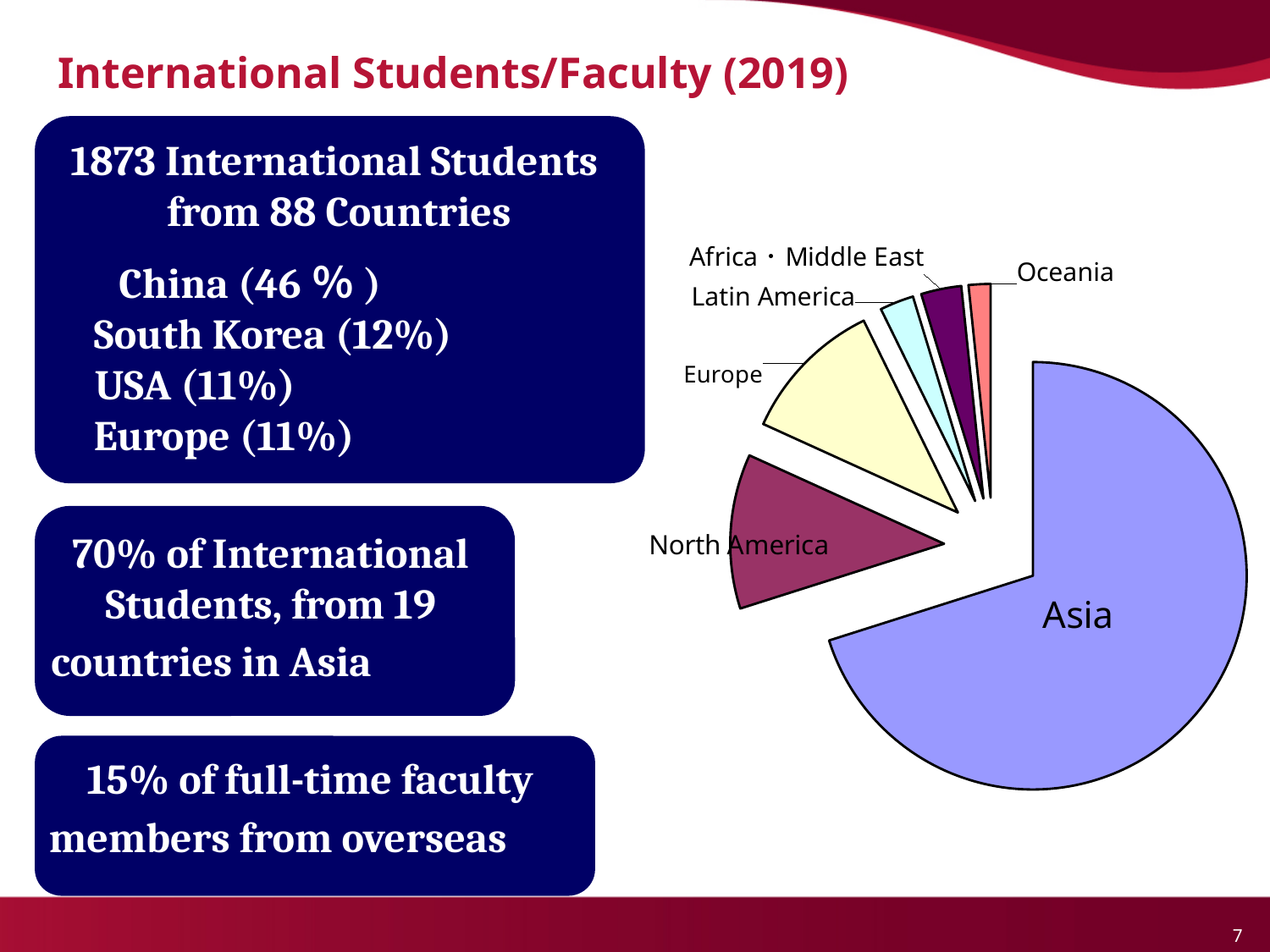
How many slices does the pie chart have? 6 Does the Asia slice take up more or less than half of the pie chart? more Which slice is larger in the pie chart, North America or Oceania? North America What colour is the Asia slice in the pie chart? lavender (light purple-blue) Which slice is larger in the pie chart, Asia or North America? Asia Which slice is larger in the pie chart, Europe or Latin America? Europe Which region has the largest slice in the pie chart? Asia What kind of chart is shown on the slide? pie chart Which slice of the pie chart is labelled with a combined region name? Africa・Middle East